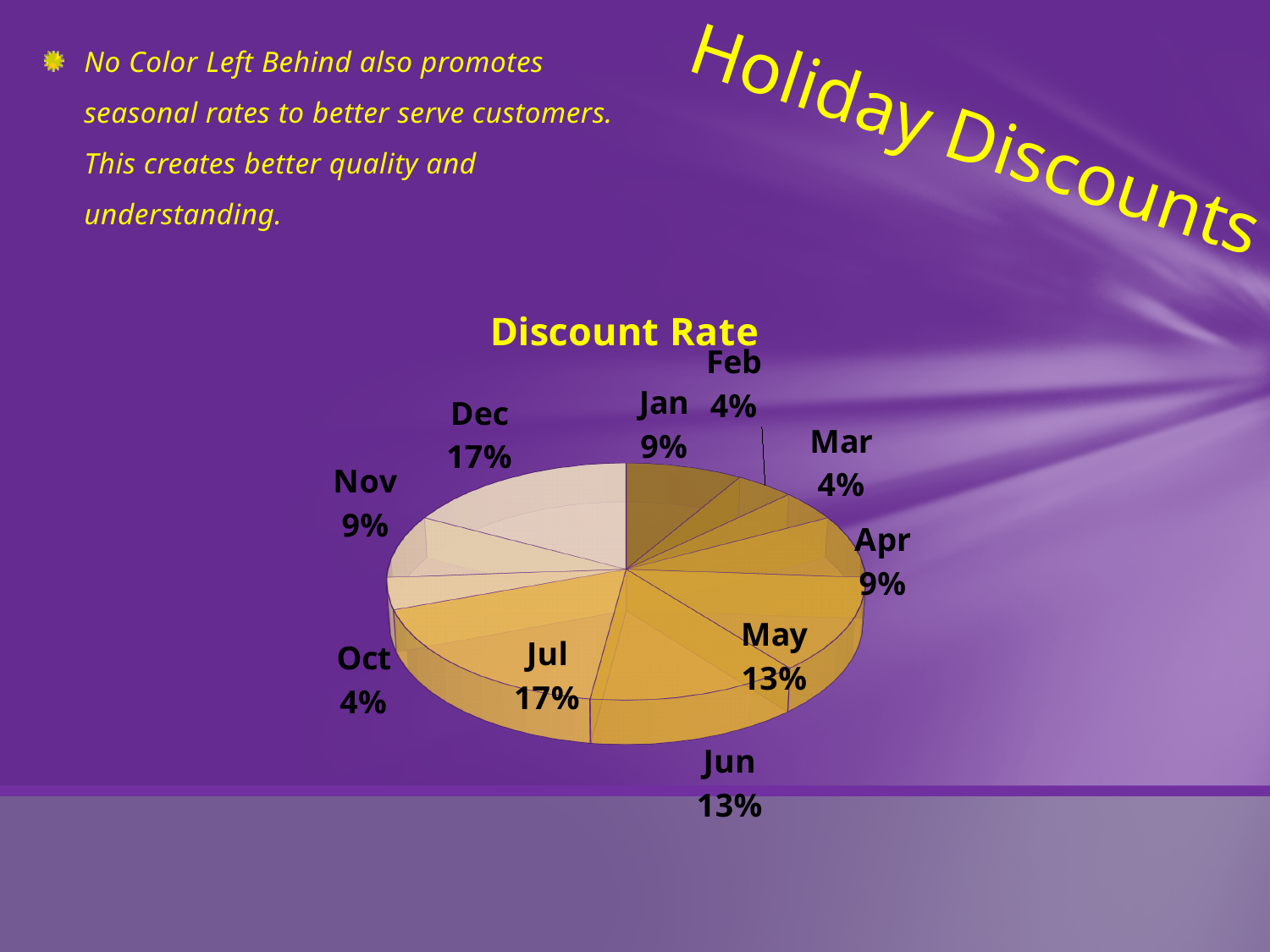
Which is larger, the discount rate for Apr or for Mar? Apr What kind of chart is shown on the slide? pie chart How many slices does the pie chart have? 10 What is the title of the chart? Discount Rate What is the discount rate for May? 13% What is the discount rate for Feb? 4% What is the discount rate for Nov? 9% Which is larger, the discount rate for Jul or for May? Jul What is the discount rate for Jul? 17% What share of the pie does Dec represent? 17% What share of the pie does Jun represent? 13% What is the difference between the discount rates for Dec and Nov? 8%